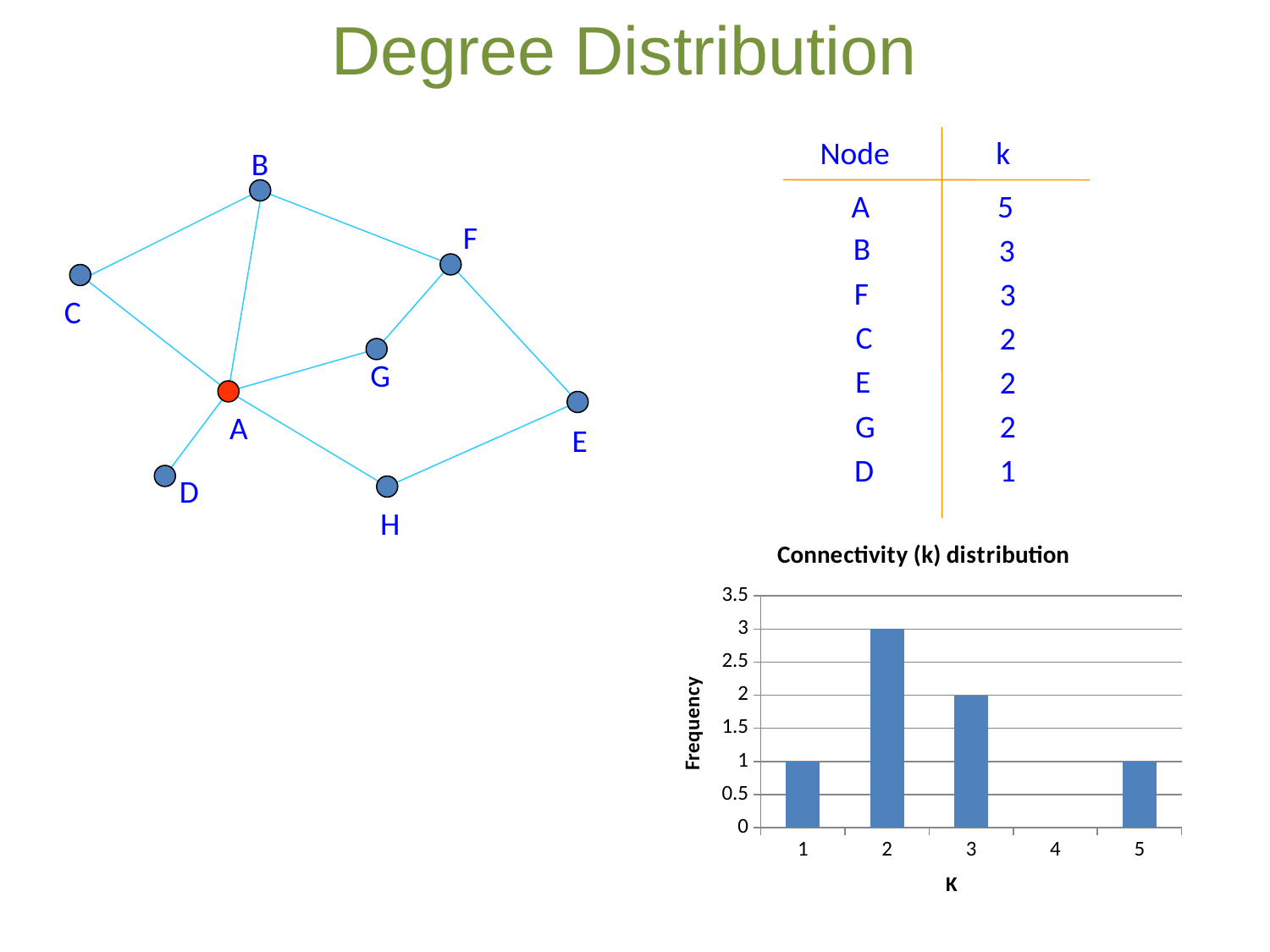
In the 'Connectivity (k) distribution' chart, what is the frequency for K = 2? 3 In the 'Connectivity (k) distribution' chart, which has a higher frequency, K = 1 or K = 3? K = 3 In the 'Connectivity (k) distribution' chart, what is the difference between the frequency for K = 2 and the frequency for K = 3? 1 In the 'Connectivity (k) distribution' chart, which value of K has the lowest frequency? 4 How many K categories are shown on the x axis of the 'Connectivity (k) distribution' chart? 5 What is the label of the y axis in the 'Connectivity (k) distribution' chart? Frequency In the 'Connectivity (k) distribution' chart, which value of K has the highest frequency? 2 In the 'Connectivity (k) distribution' chart, what is the frequency for K = 4? 0 What type of chart is the 'Connectivity (k) distribution' chart? bar chart In the 'Connectivity (k) distribution' chart, what is the frequency for K = 5? 1 What is the title of the chart on the slide? Connectivity (k) distribution In the 'Connectivity (k) distribution' chart, what is the frequency for K = 3? 2